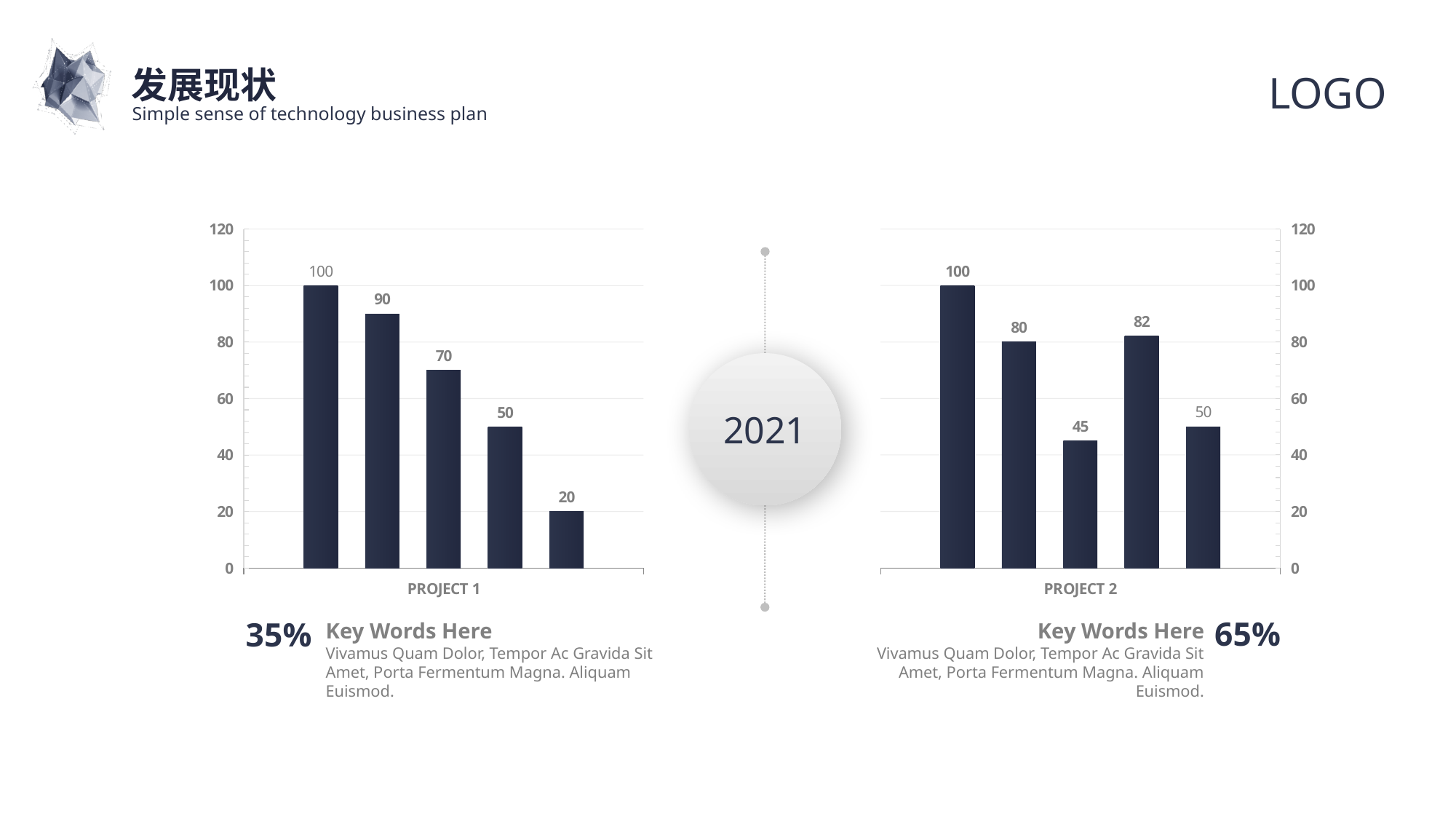
What type of chart is used for PROJECT 2 on the right? Bar chart In the PROJECT 2 chart on the right, what is the value of the fourth bar? 82 In the PROJECT 2 chart on the right, which is larger: the second bar or the fourth bar? The fourth bar (82) In the PROJECT 1 chart on the left, what is the difference between the first bar and the last bar? 80 In the PROJECT 2 chart on the right, which bar has the lowest value? The third bar (45) In the PROJECT 2 chart on the right, what is the value of the third bar? 45 In the PROJECT 1 chart on the left, what is the value of the last (rightmost) bar? 20 In the PROJECT 2 chart on the right, what is the difference between the second bar and the third bar? 35 What is the maximum value shown on the vertical axis of the PROJECT 1 chart? 120 In the PROJECT 1 chart on the left, do the bar values rise or fall from left to right? Fall How many bars are plotted in the PROJECT 1 chart on the left? 5 In the PROJECT 1 chart on the left, what is the value of the first (leftmost) bar? 100